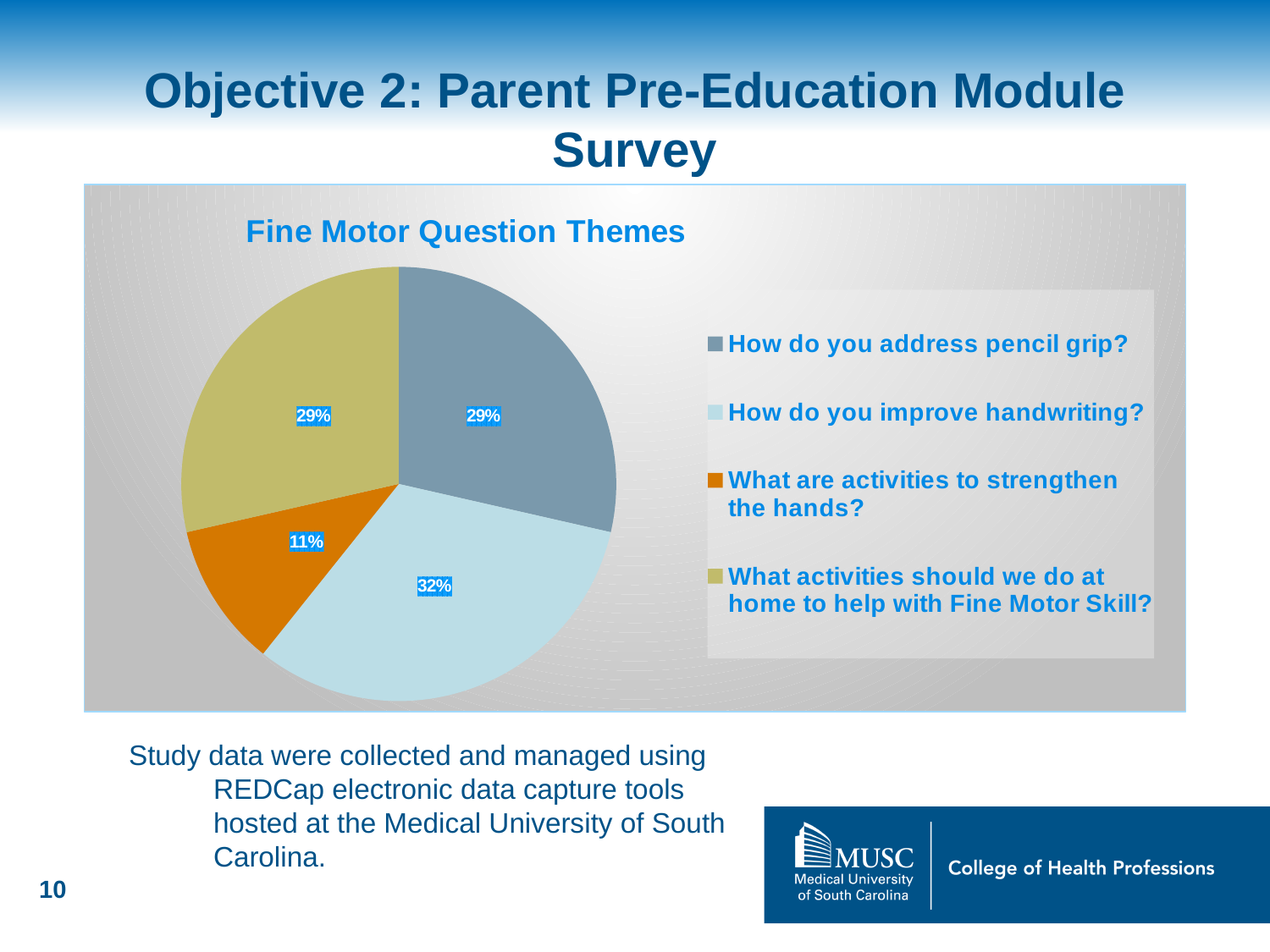
What share of the pie is "How do you address pencil grip?"? 29% Which question theme has the largest share of the pie? How do you improve handwriting? How many slices does the pie chart have? 4 Which question theme has the smallest share of the pie? What are activities to strengthen the hands? What share of the pie is "What are activities to strengthen the hands?"? 11% What is the difference in percentage points between "How do you improve handwriting?" and "What are activities to strengthen the hands?"? 21% What is the title of the chart? Fine Motor Question Themes Which colour represents "What are activities to strengthen the hands?" in the legend? orange What share of the pie is "What activities should we do at home to help with Fine Motor Skill?"? 29% What kind of chart is shown on the slide? pie chart Which is larger: the share for "How do you improve handwriting?" or the share for "How do you address pencil grip?"? How do you improve handwriting?